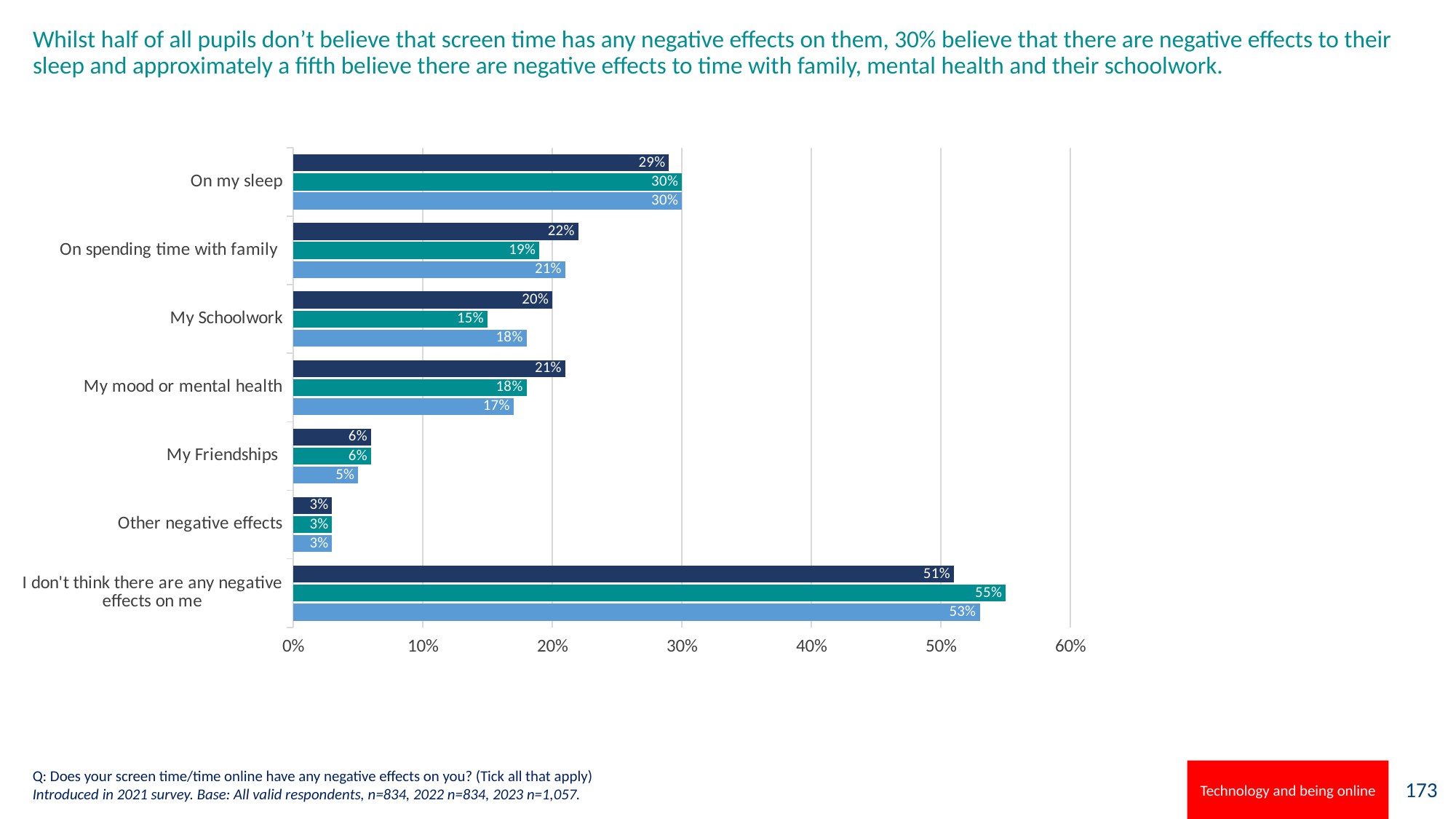
What kind of chart is shown on the slide? bar chart How many bars are shown for each category in the chart? 3 What is the value of the teal (middle) bar for 'On my sleep'? 30% Which is larger for 'My mood or mental health': the dark navy (top) bar or the light blue (bottom) bar? the dark navy (top) bar What is the value of the light blue (bottom) bar for 'My Schoolwork'? 18% Is the teal (middle) bar for 'I don't think there are any negative effects on me' greater or less than 50%? greater How many categories are listed on the vertical axis of the chart? 7 Which category has the lowest light blue (bottom) bar value? Other negative effects What is the value of the dark navy (top) bar for 'On spending time with family'? 22% What is the difference between the dark navy (top) bar and the teal (middle) bar for 'My Schoolwork'? 5% Which category has the highest dark navy (top) bar value? I don't think there are any negative effects on me What is the value of the teal (middle) bar for 'I don't think there are any negative effects on me'? 55%